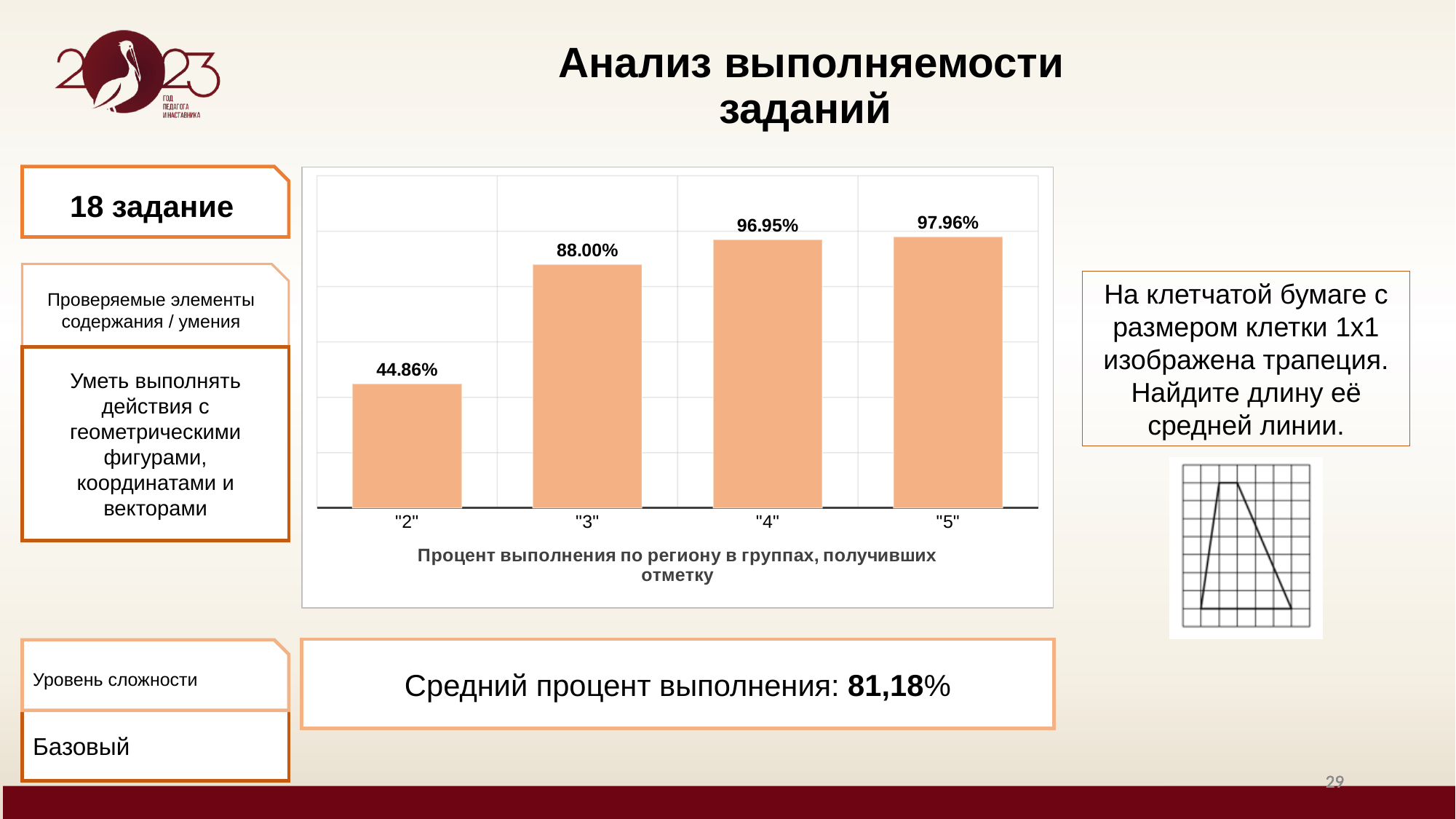
What is the completion percentage for the group that received mark "3"? 88.00% What is the completion percentage for the group that received mark "2"? 44.86% What is the difference in completion percentage between the "5" group and the "4" group? 1.01% What type of chart is shown on the slide? Bar chart Which mark group has the lowest completion percentage? "2" What is the completion percentage for the group that received mark "5"? 97.96% Which mark group has the highest completion percentage? "5" Which group has a higher completion percentage, "3" or "4"? "4" What is the completion percentage for the group that received mark "4"? 96.95% How many mark groups are shown in the chart? 4 Do the completion percentages rise or fall from mark "2" to mark "5"? Rise What is the difference in completion percentage between the "3" group and the "2" group? 43.14%